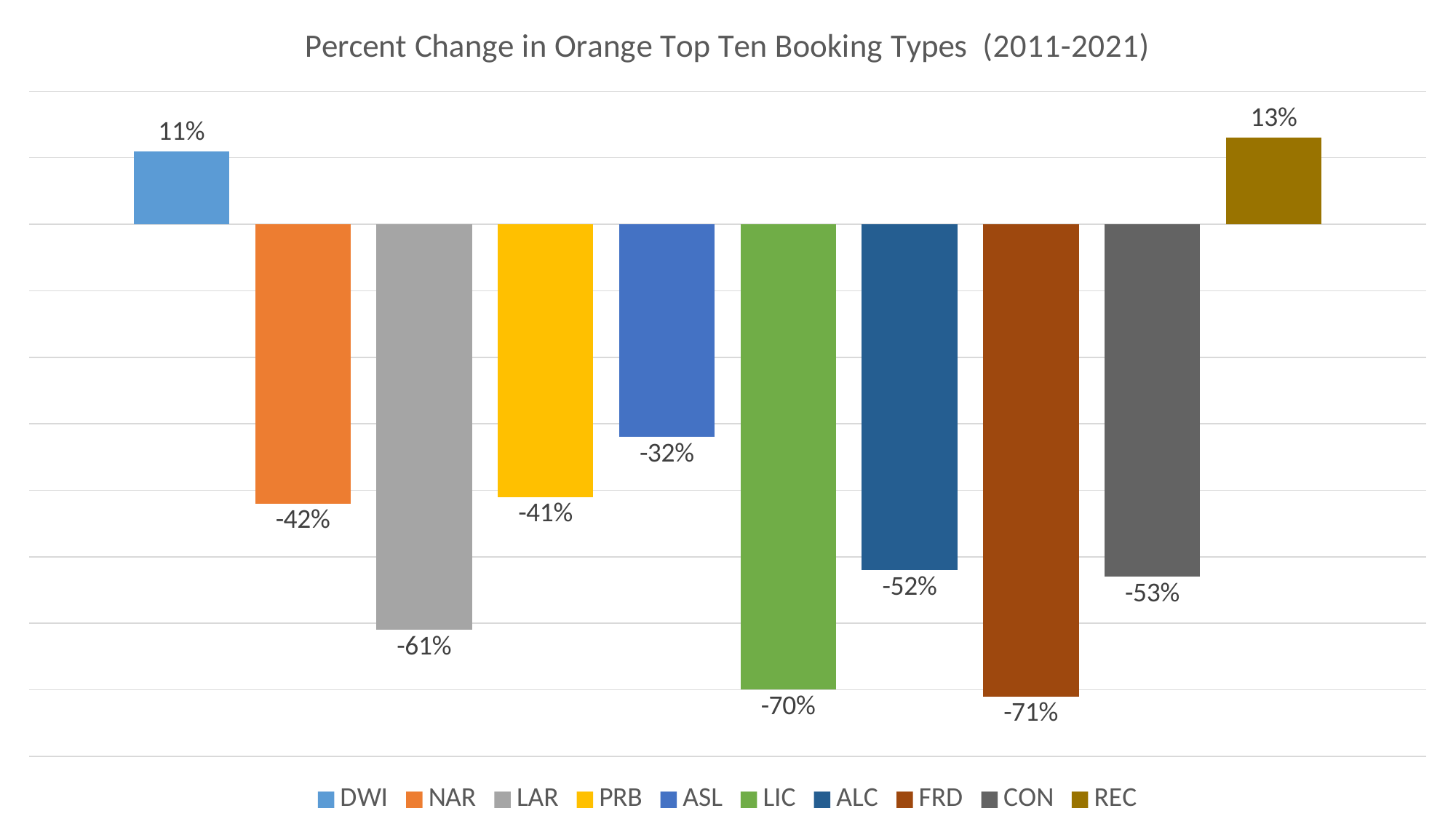
What is the difference between the percent change for REC and the percent change for DWI? 2% How many booking types are shown in the chart? 10 What kind of chart is shown on the slide? Bar chart Which booking type has the lowest percent change? FRD Which has a larger percent change, NAR or PRB? PRB What is the difference between the percent change for ASL and the percent change for LIC? 38% Which has a larger percent change, ALC or CON? ALC What is the percent change for REC? 13% What is the title of the chart? Percent Change in Orange Top Ten Booking Types (2011-2021) What is the percent change for ASL? -32% Which booking type has the highest percent change? REC What is the percent change for LAR? -61%